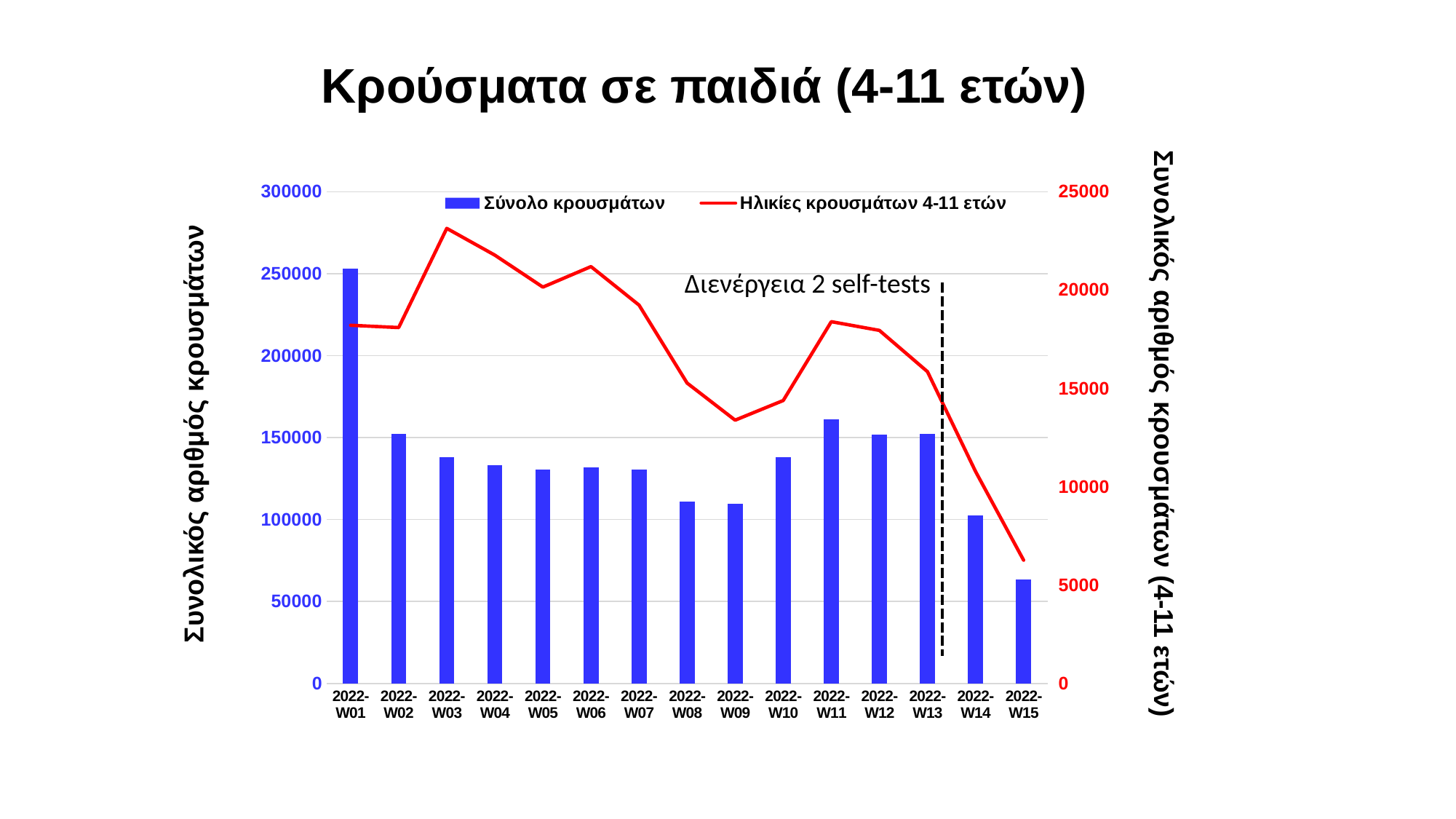
In which week does the line Ηλικίες κρουσμάτων 4-11 ετών reach its highest point? 2022-W03 Which week has the highest bar for Σύνολο κρουσμάτων? 2022-W01 How many series does the legend list? 2 Which week has the larger Σύνολο κρουσμάτων bar, 2022-W11 or 2022-W09? 2022-W11 How many weeks are shown on the x axis? 15 Is the Σύνολο κρουσμάτων bar for 2022-W01 greater or less than 200000? greater Is the Ηλικίες κρουσμάτων 4-11 ετών value for 2022-W03 greater or less than 20000? greater Is the Σύνολο κρουσμάτων bar for 2022-W15 greater or less than 100000? less What type of chart is shown on the slide? A combined bar and line chart Does the line Ηλικίες κρουσμάτων 4-11 ετών rise or fall from 2022-W11 to 2022-W15? fall Which week has the lowest bar for Σύνολο κρουσμάτων? 2022-W15 In which week does the line Ηλικίες κρουσμάτων 4-11 ετών reach its lowest point? 2022-W15